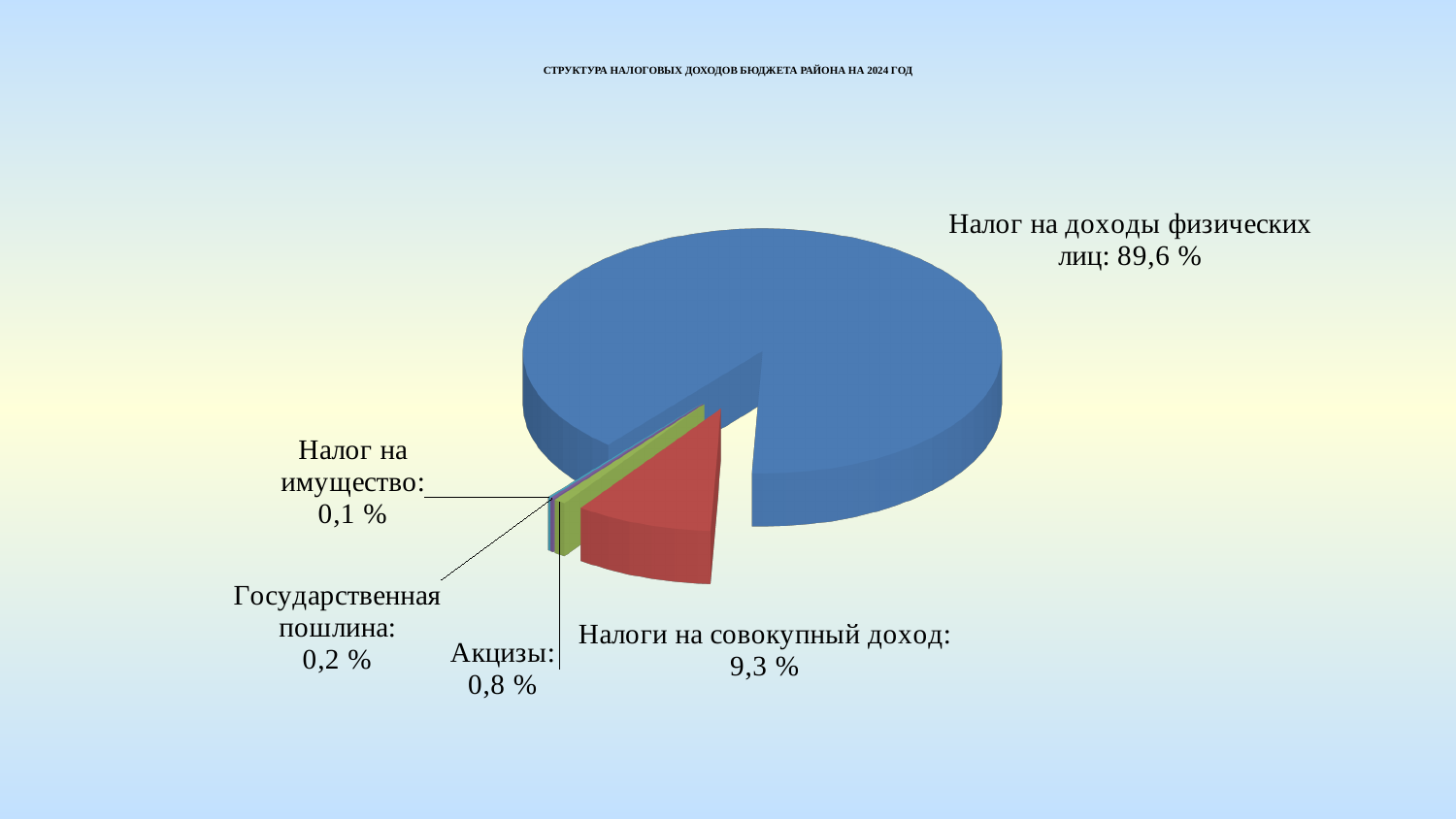
What value is shown for "Налог на имущество"? 0,1 % What kind of chart is shown on the slide? Pie chart What is the difference between the shares of "Налог на доходы физических лиц" and "Налоги на совокупный доход"? 80,3 % What value is shown for "Налоги на совокупный доход"? 9,3 % What share of the pie does "Налог на доходы физических лиц" have? 89,6 % What is the title of the chart on the slide? СТРУКТУРА НАЛОГОВЫХ ДОХОДОВ БЮДЖЕТА РАЙОНА НА 2024 ГОД Which category has the largest share of the pie? Налог на доходы физических лиц How many categories are shown in the pie chart? 5 Which is larger: the share of "Акцизы" or the share of "Государственная пошлина"? Акцизы What value is shown for "Государственная пошлина"? 0,2 % What value is shown for "Акцизы"? 0,8 % Which category has the smallest share of the pie? Налог на имущество